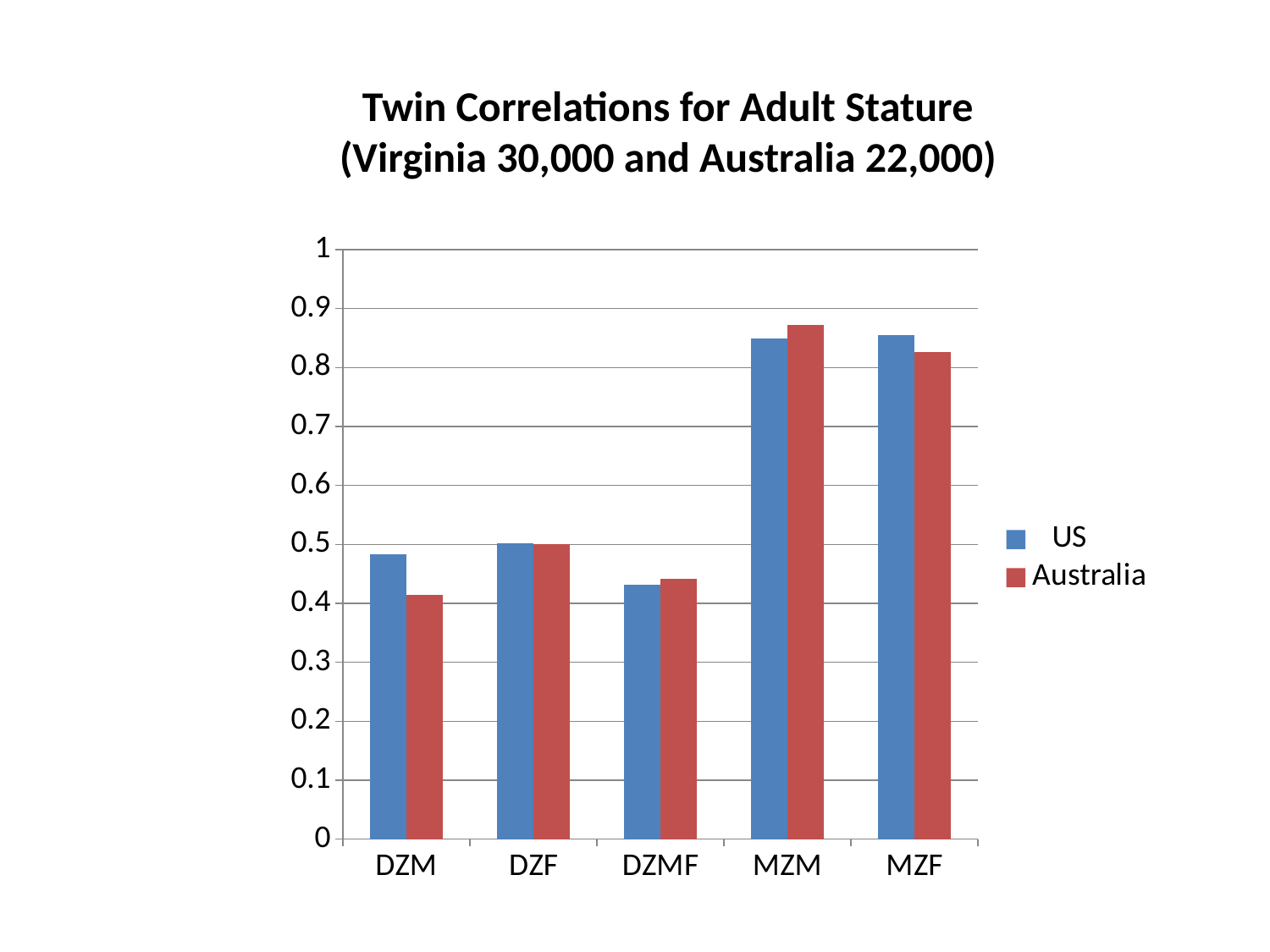
How many categories are shown on the x axis? 5 What is the title of the chart? Twin Correlations for Adult Stature (Virginia 30,000 and Australia 22,000) Is the US value for DZMF greater or less than 0.5? less What kind of chart is shown on the slide? bar chart Which category has the lowest value for the Australia series? DZM Which category has the highest value for the Australia series? MZM Is the Australia value for MZM greater or less than 0.8? greater How many series does the legend list? 2 For MZF, which series has the larger value, US or Australia? US Which category has the lowest value for the US series? DZMF For DZM, which series has the larger value, US or Australia? US Is the Australia value for DZM greater or less than 0.5? less